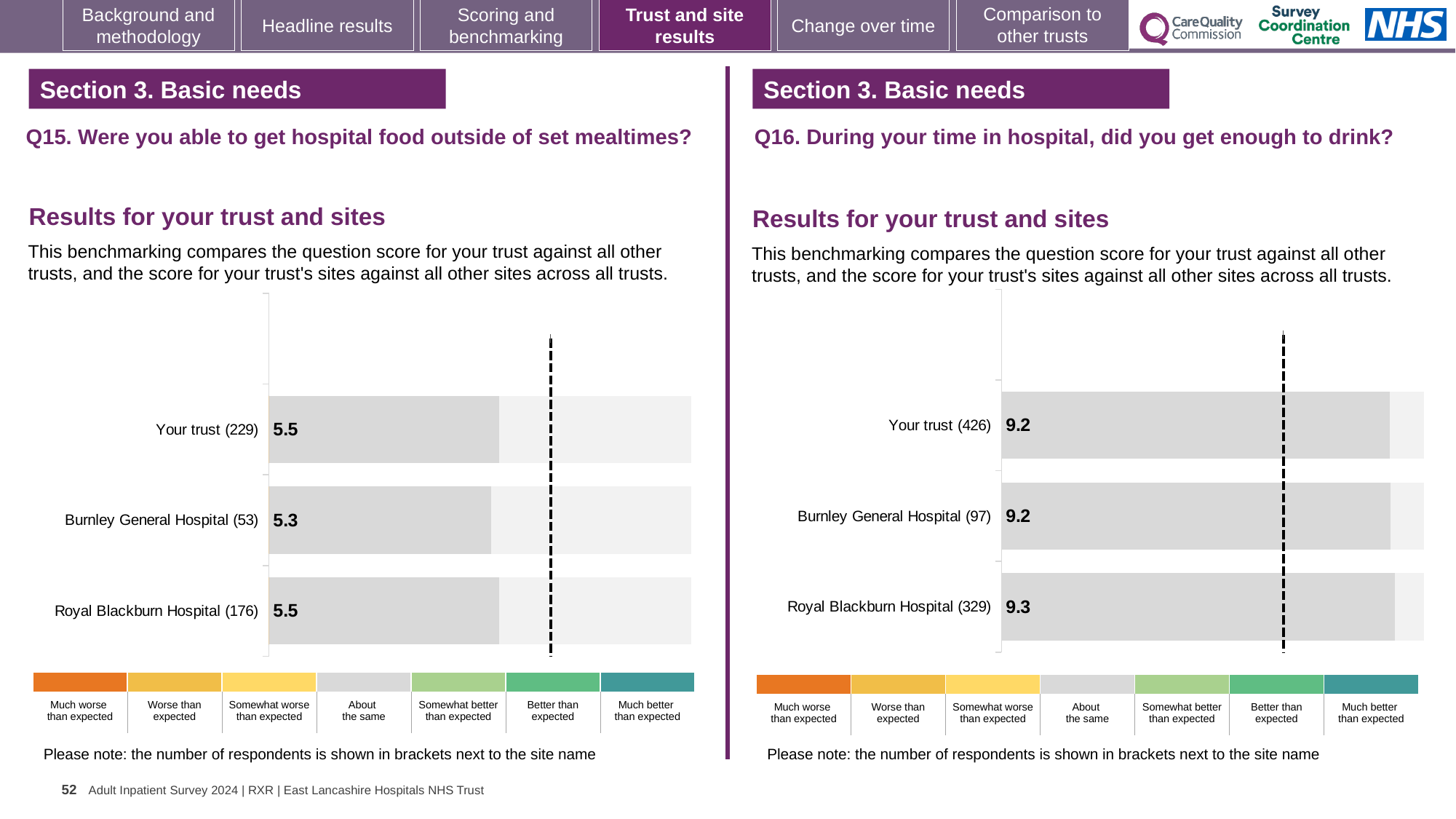
In the Q15 chart on the left, what is the score for Royal Blackburn Hospital (176)? 5.5 In the Q15 chart on the left, how many bars are plotted? 3 How many categories does the colour key below the Q15 chart list? 7 In the Q15 chart on the left, which site or trust has the lowest score? Burnley General Hospital (53) In the Q15 chart on the left, what is the score for Your trust (229)? 5.5 What kind of chart is used for the Q16 results on the right? Bar chart In the Q16 chart on the right, what is the score for Royal Blackburn Hospital (329)? 9.3 In the Q16 chart on the right, what is the score for Your trust (426)? 9.2 In the Q16 chart on the right, what is the difference between the scores for Royal Blackburn Hospital (329) and Burnley General Hospital (97)? 0.1 In the Q16 chart on the right, which site or trust has the highest score? Royal Blackburn Hospital (329) In the Q15 chart on the left, what is the score for Burnley General Hospital (53)? 5.3 In the Q15 chart on the left, what is the difference between the scores for Your trust (229) and Burnley General Hospital (53)? 0.2